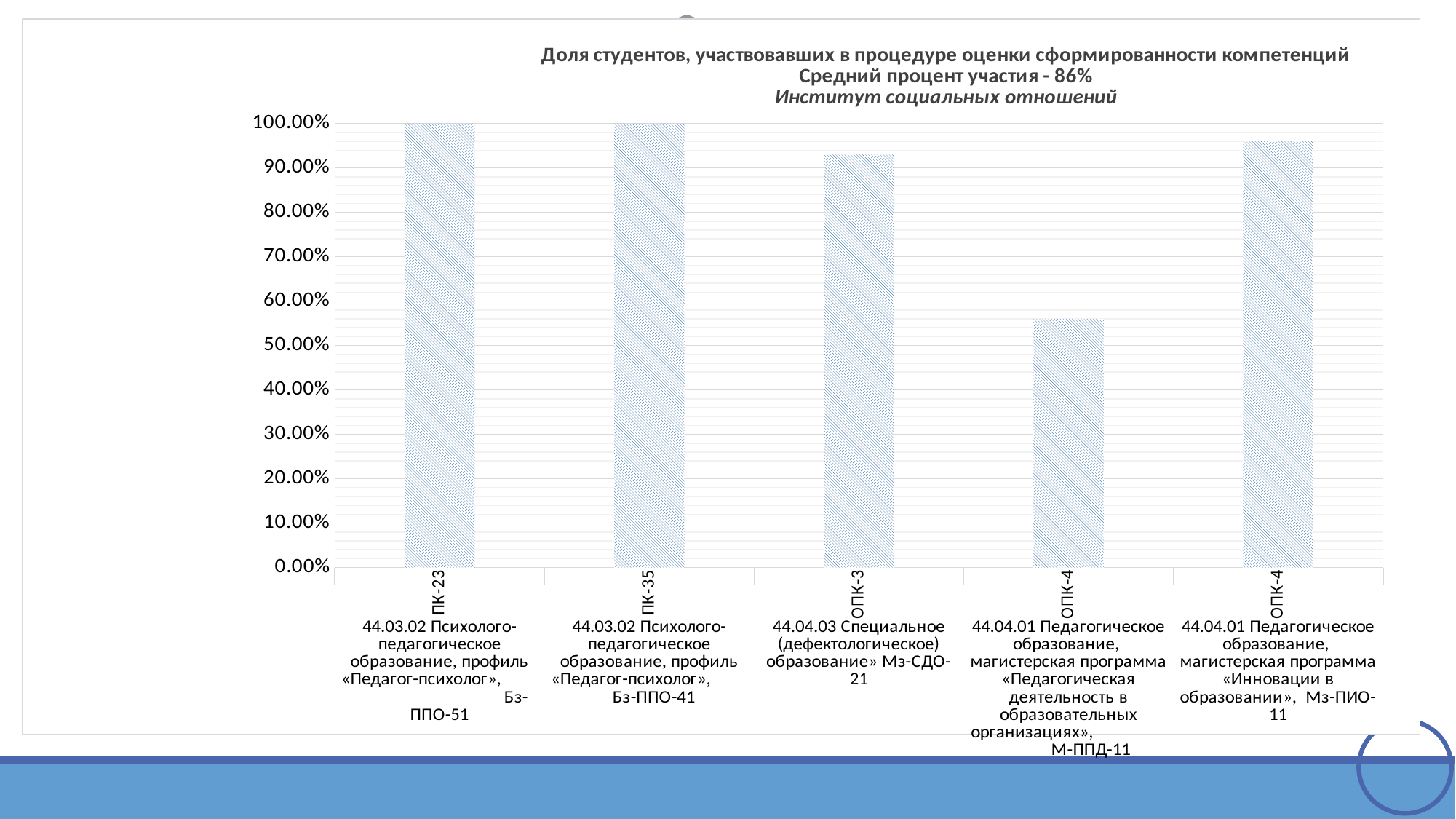
What is the value for the Бз-ППО-41 group (ПК-35)? 100.00% What type of chart is shown on the slide? Bar chart Which group has the lowest share of students who participated in the assessment? М-ППД-11 (44.04.01 Педагогическое образование, «Педагогическая деятельность в образовательных организациях») How many bars (categories) are plotted in the chart? 5 What is the value for the Бз-ППО-51 group (ПК-23)? 100.00% Is the value for the Мз-СДО-21 group (ОПК-3) greater or less than 90.00%? greater Is the value for the Мз-ПИО-11 group (ОПК-4) greater or less than 90.00%? greater How many bars reach 100.00%? 2 Which institute is named in the chart title? Институт социальных отношений Is the value for the М-ППД-11 group (ОПК-4) greater or less than 60.00%? less What average participation percentage is stated in the chart title? 86% Which is larger: the value for Мз-СДО-21 or the value for М-ППД-11? Мз-СДО-21